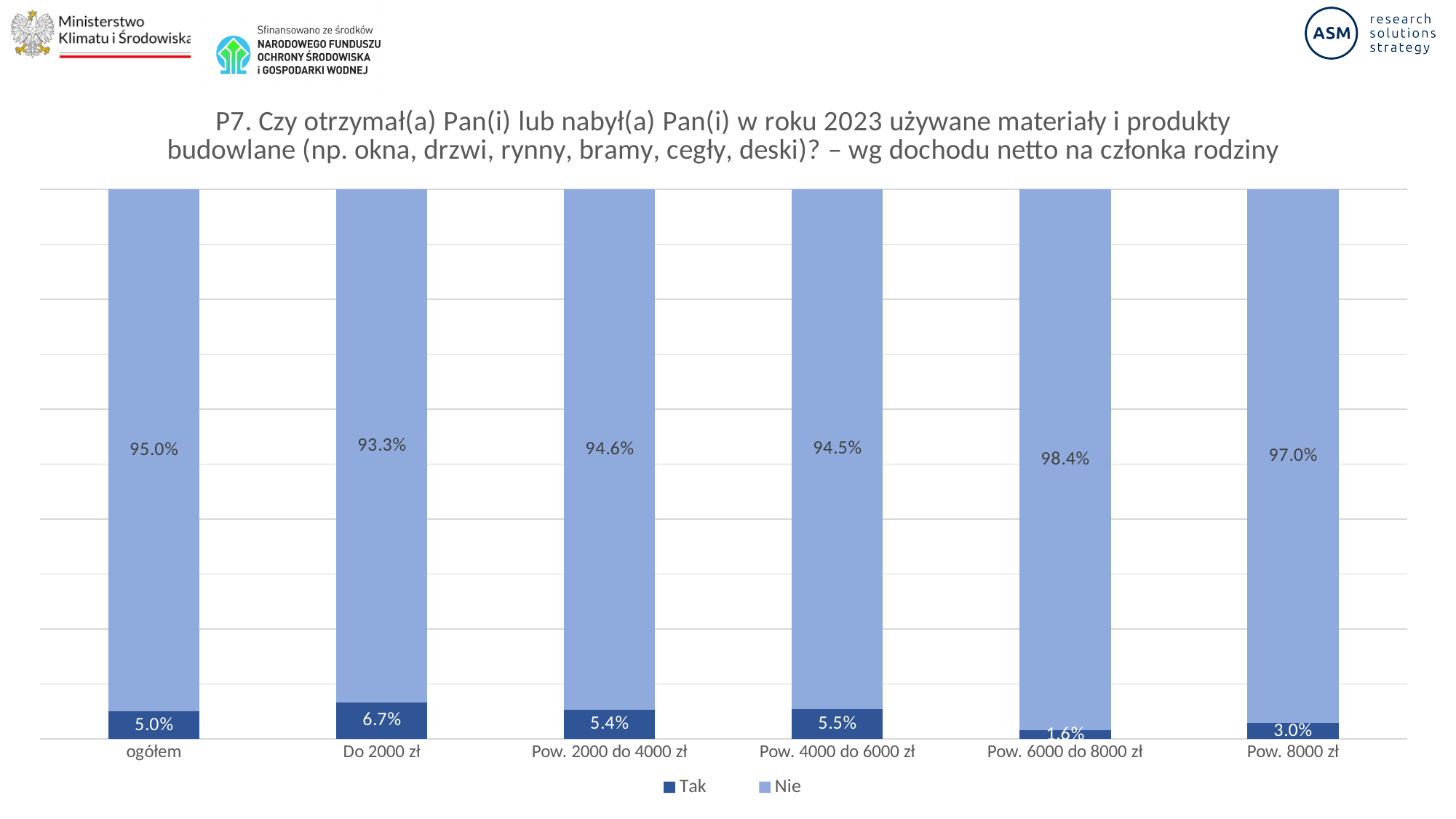
What is the difference between the 'Nie' values for 'Pow. 8000 zł' and 'Do 2000 zł'? 3.7% What is the 'Nie' value for the 'Pow. 6000 do 8000 zł' category? 98.4% Which series is shown in dark blue in the legend? Tak Which category has the highest 'Tak' value? Do 2000 zł What is the 'Tak' value for the 'Do 2000 zł' category? 6.7% What kind of chart is shown on the slide? stacked bar chart Which category has the lowest 'Tak' value? Pow. 6000 do 8000 zł How many income categories are shown on the x axis? 6 How many series does the legend list? 2 What is the total of the stacked bar for 'Pow. 4000 do 6000 zł'? 100.0% What is the 'Tak' value for 'ogółem'? 5.0% Which is larger: the 'Tak' value for 'Pow. 2000 do 4000 zł' or for 'Pow. 8000 zł'? Pow. 2000 do 4000 zł